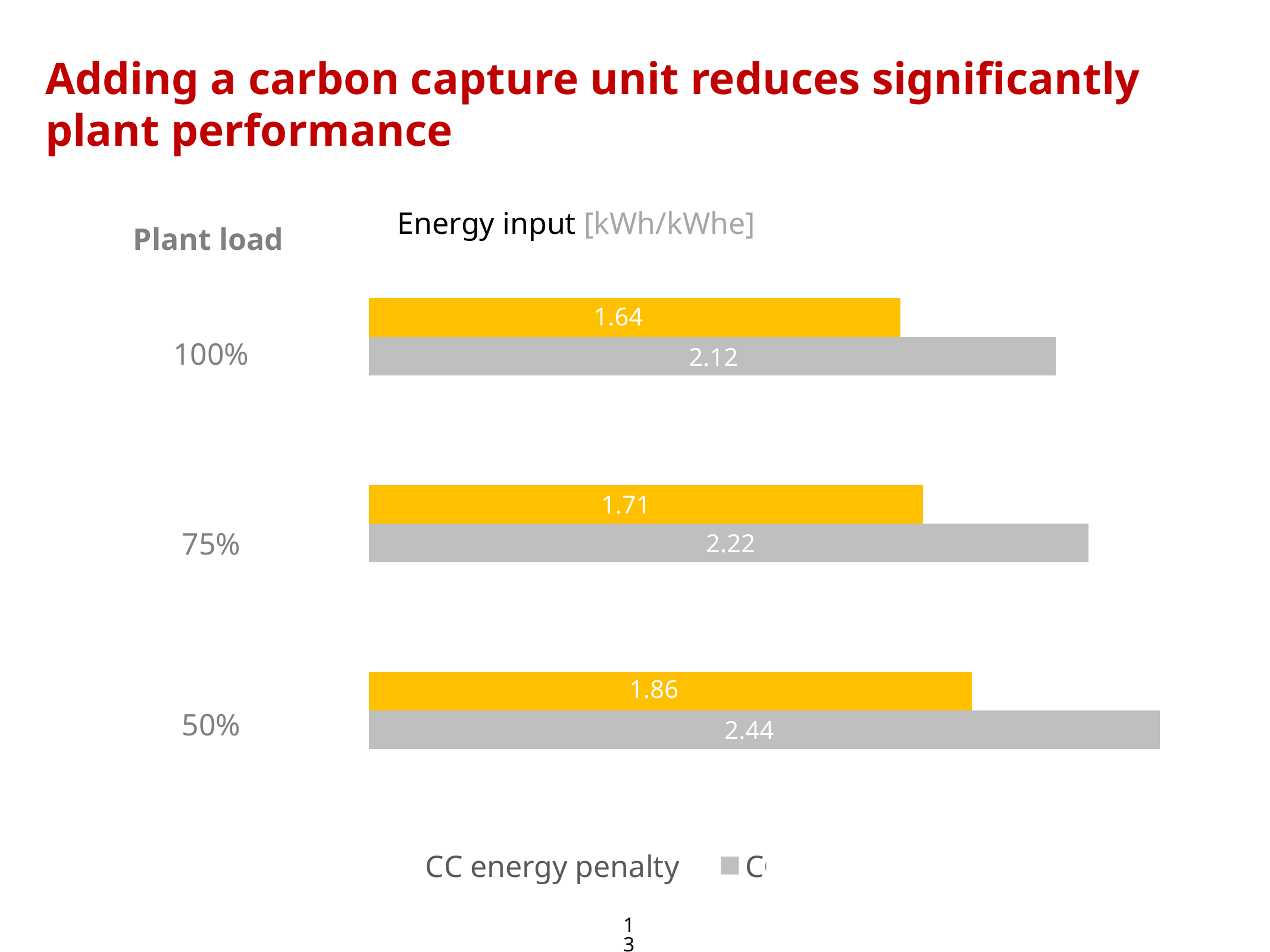
Which plant load has the highest grey bar value? 50% Which is larger: the yellow bar at 50% plant load or the yellow bar at 100% plant load? 50% plant load What unit is given for the energy input in the chart heading? kWh/kWhe Which plant load has the lowest yellow bar value? 100% How many plant load categories are shown in the chart? 3 What is the value of the grey bar for the 75% plant load? 2.22 What type of chart is shown on the slide? Bar chart What is the difference between the grey and yellow bar values at 50% plant load? 0.58 What is the value of the yellow bar for the 100% plant load? 1.64 What is the value of the yellow bar for the 75% plant load? 1.71 What is the value of the grey bar for the 50% plant load? 2.44 Do the grey bar values increase or decrease as plant load goes from 100% down to 50%? Increase